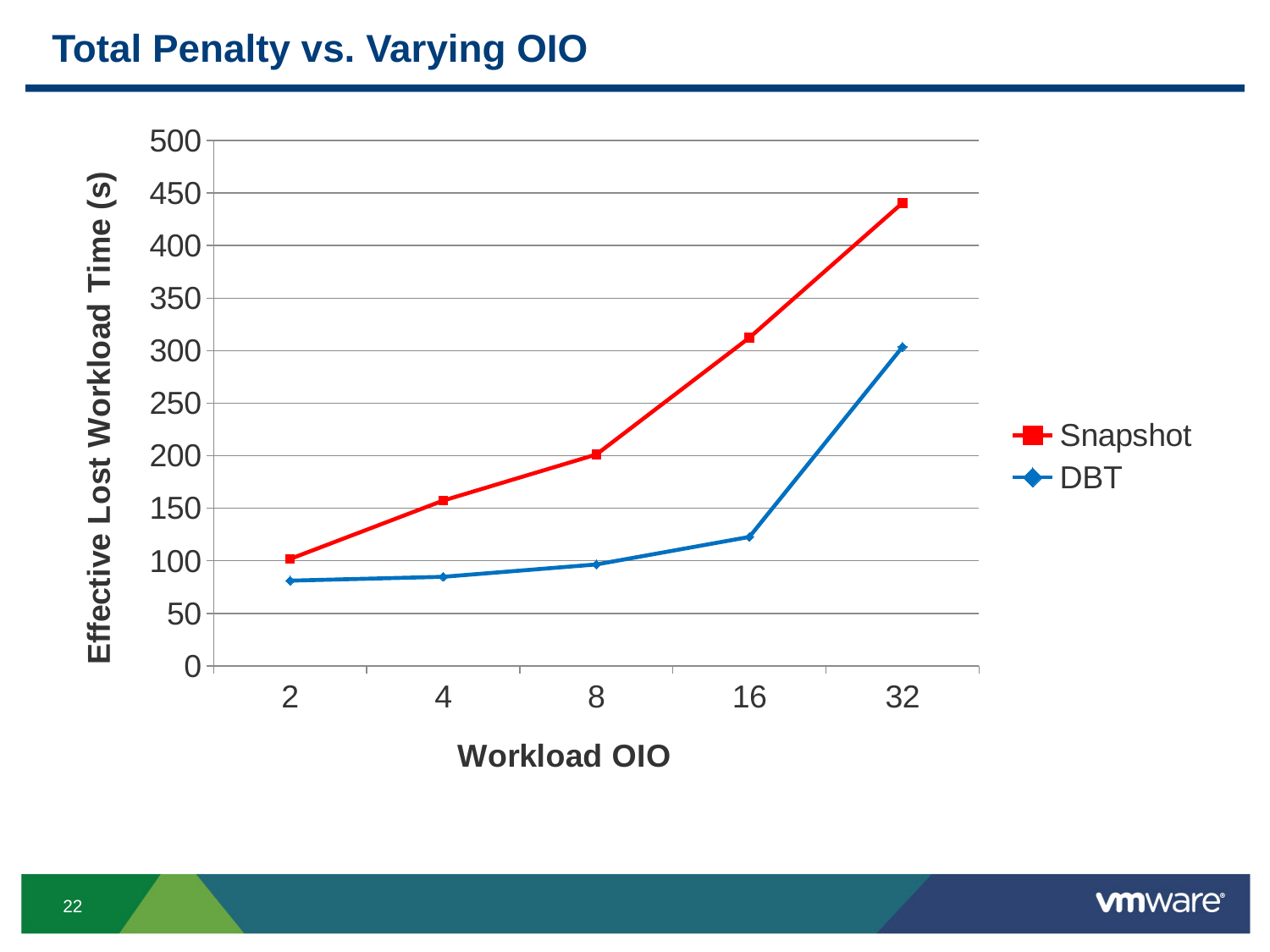
At which Workload OIO is the DBT series at its lowest value? 2 At which Workload OIO does the Snapshot series reach its highest value? 32 Is the DBT value at Workload OIO 2 greater or less than 100? less What is the label of the y axis? Effective Lost Workload Time (s) What kind of chart is shown on the slide? line chart Do the Snapshot values rise or fall as Workload OIO increases from 2 to 32? rise How many Workload OIO values are plotted along the x axis? 5 Is the Snapshot value at Workload OIO 8 greater or less than 150? greater How many series does the legend list? 2 Is the Snapshot value at Workload OIO 32 greater or less than 400? greater At Workload OIO 8, which series has the larger Effective Lost Workload Time, Snapshot or DBT? Snapshot